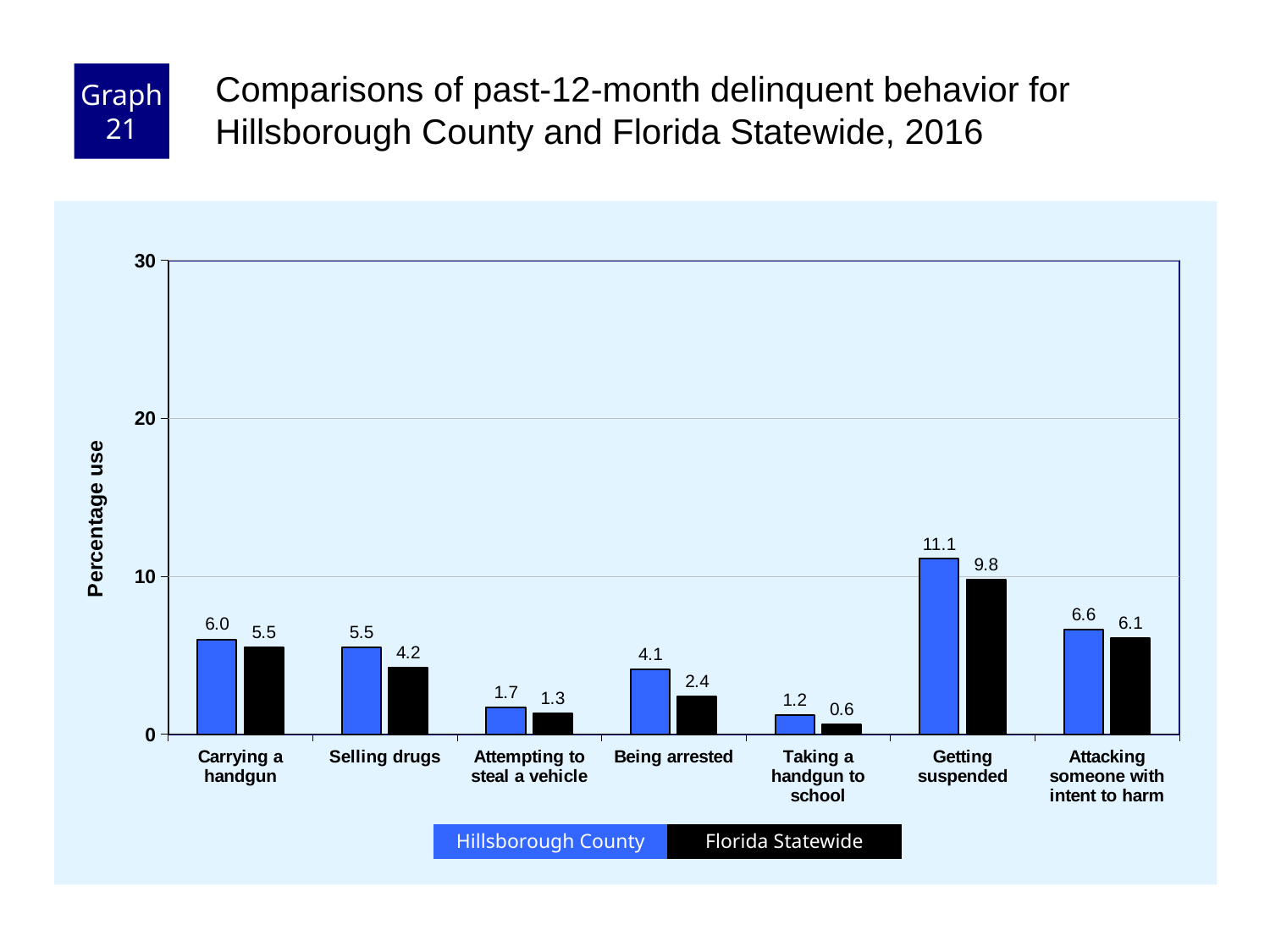
What is the label of the y axis? Percentage use Is the Hillsborough County value for Getting suspended greater or less than 10? greater Which category has the highest Florida Statewide value? Getting suspended What is the Florida Statewide value for Selling drugs? 4.2 What is the Hillsborough County value for Taking a handgun to school? 1.2 How many series does the legend list? 2 Which category has the lowest Hillsborough County value? Taking a handgun to school What is the difference between the Hillsborough County and Florida Statewide values for Being arrested? 1.7 What is the Hillsborough County value for Getting suspended? 11.1 How many categories are shown on the x axis? 7 Which is larger for Attacking someone with intent to harm: Hillsborough County or Florida Statewide? Hillsborough County What kind of chart is shown? bar chart